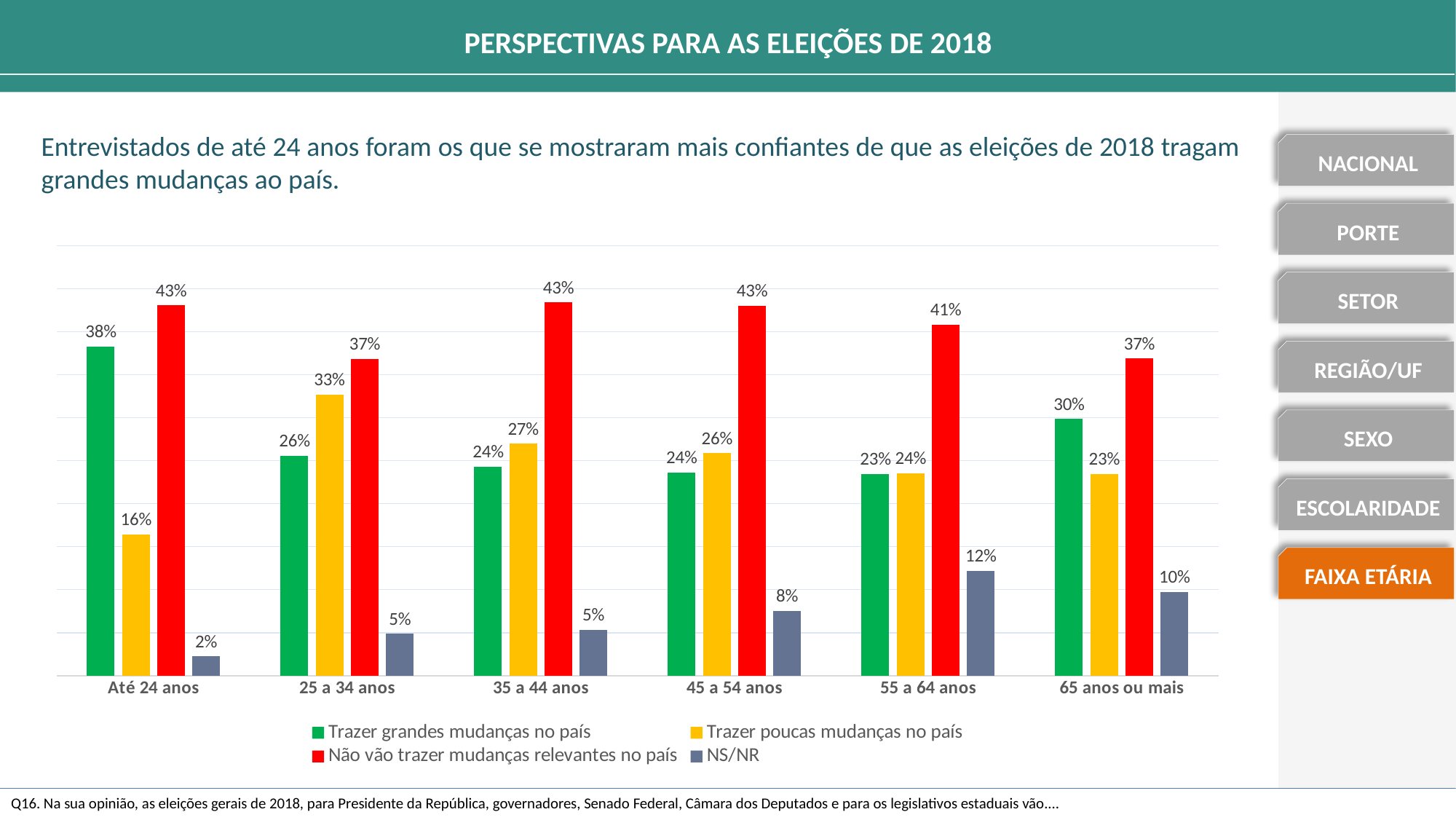
What type of chart is shown on the slide? Bar chart What is the value of 'Trazer poucas mudanças no país' for the '25 a 34 anos' group? 33% Does the value of 'NS/NR' rise or fall from 'Até 24 anos' to '55 a 64 anos'? Rise What is the difference between 'Não vão trazer mudanças relevantes no país' and 'Trazer grandes mudanças no país' for the '65 anos ou mais' group? 7% What percentage of respondents aged 'Até 24 anos' chose 'Trazer grandes mudanças no país'? 38% How many series does the chart legend list? 4 Which colour represents 'Não vão trazer mudanças relevantes no país' in the chart? Red Which age group has the lowest value for 'NS/NR'? Até 24 anos For the '25 a 34 anos' group, which is larger: 'Trazer grandes mudanças no país' or 'Trazer poucas mudanças no país'? Trazer poucas mudanças no país How many age groups are shown on the x axis of the chart? 6 Which age group has the highest value for 'Trazer grandes mudanças no país'? Até 24 anos What is the value of 'NS/NR' for the '55 a 64 anos' group? 12%